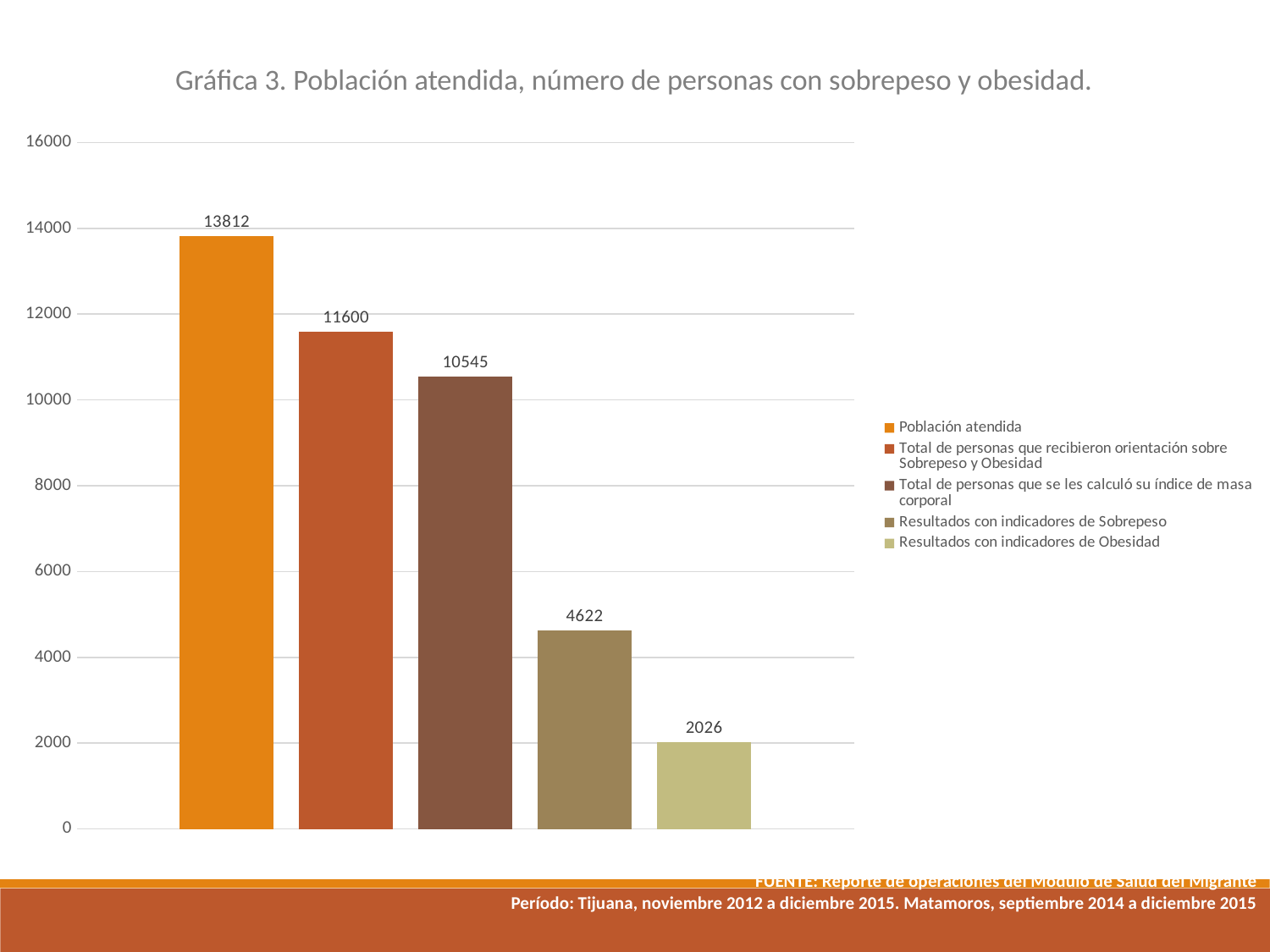
Which series has the highest value? Población atendida What kind of chart is shown on the slide? Bar chart How many series does the legend list? 5 What is the title of the chart? Gráfica 3. Población atendida, número de personas con sobrepeso y obesidad. What is the difference between Población atendida and Total de personas que se les calculó su índice de masa corporal? 3267 What is the value for Población atendida? 13812 What is the value for Resultados con indicadores de Obesidad? 2026 Which series has the lowest value? Resultados con indicadores de Obesidad What is the value for Resultados con indicadores de Sobrepeso? 4622 Which is larger: Total de personas que recibieron orientación sobre Sobrepeso y Obesidad or Total de personas que se les calculó su índice de masa corporal? Total de personas que recibieron orientación sobre Sobrepeso y Obesidad What is the value for Total de personas que recibieron orientación sobre Sobrepeso y Obesidad? 11600 What is the difference between Resultados con indicadores de Sobrepeso and Resultados con indicadores de Obesidad? 2596